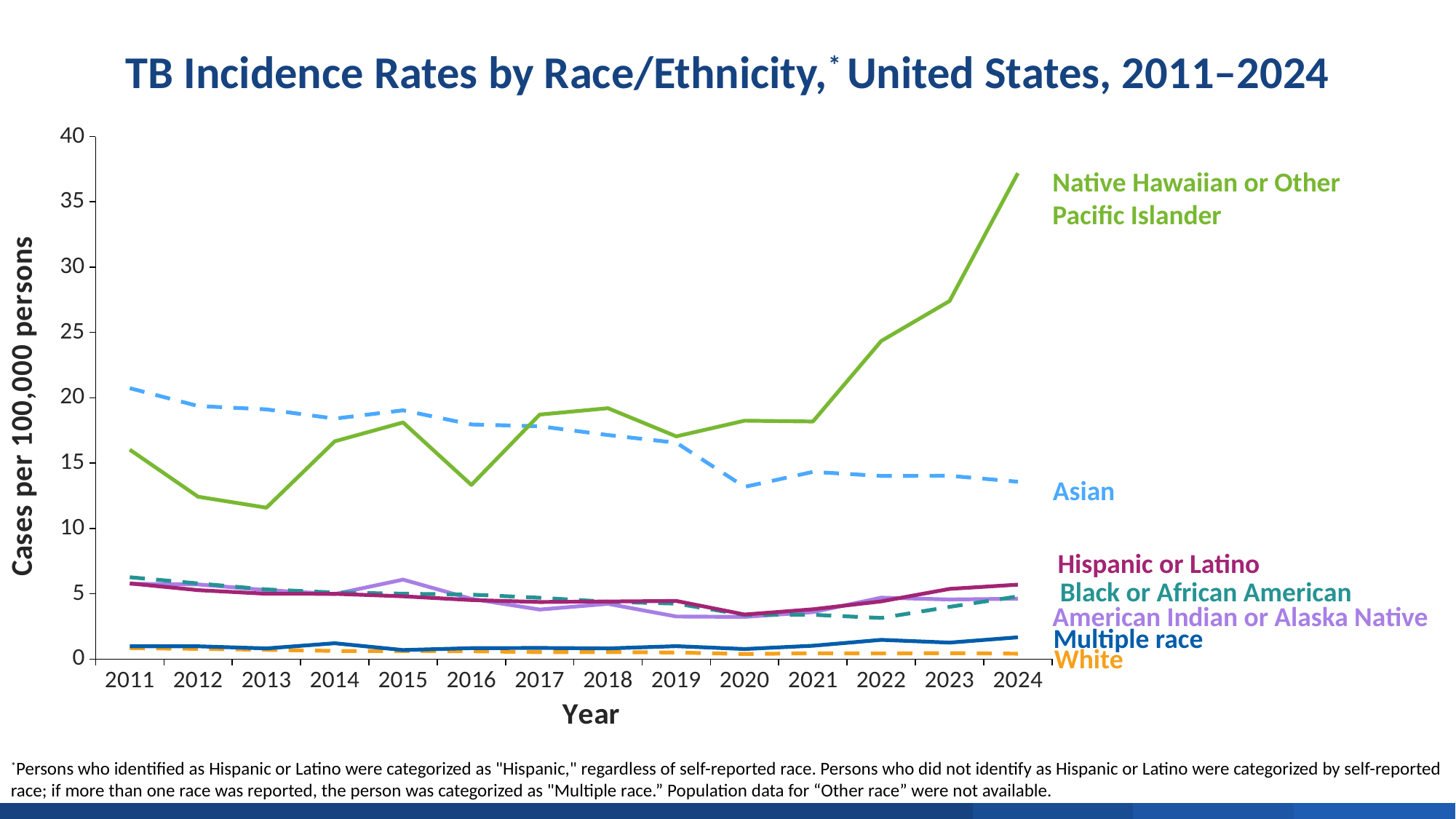
In 2011, which was larger: the rate for Asian or for Native Hawaiian or Other Pacific Islander? Asian What is the label of the y axis? Cases per 100,000 persons Which race/ethnicity group has the highest TB incidence rate in 2024? Native Hawaiian or Other Pacific Islander How many race/ethnicity series are plotted on the chart? 7 How many years are shown along the x axis? 14 Is the 2024 value for Asian greater or less than 15? less What kind of chart is shown on the slide? Line chart Which race/ethnicity group had the highest TB incidence rate in 2011? Asian Does the Native Hawaiian or Other Pacific Islander line rise or fall from 2021 to 2024? rise Which race/ethnicity group has the lowest TB incidence rate in 2024? White Does the Asian line rise or fall overall from 2011 to 2024? fall Is the 2024 value for Native Hawaiian or Other Pacific Islander greater or less than 35? greater